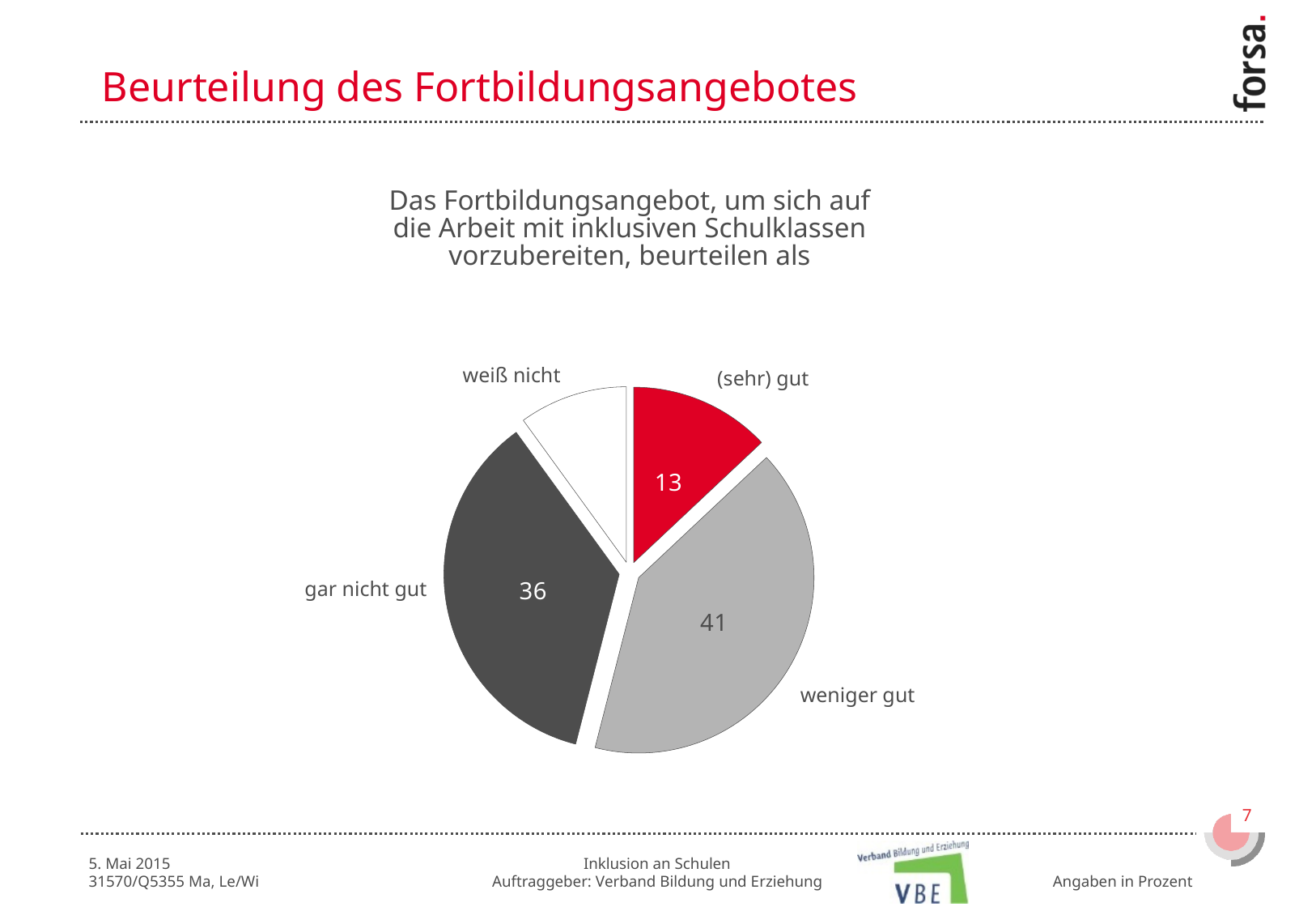
Which category has the smallest slice of the pie? weiß nicht Which is larger, the value for "gar nicht gut" or the value for "(sehr) gut"? gar nicht gut In what unit are the values given, according to the note at the bottom right of the slide? Prozent Which category has the largest slice of the pie? weniger gut What is the value for "gar nicht gut"? 36 What is the value for "(sehr) gut"? 13 How many slices does the pie chart have? 4 What is the value for "weniger gut"? 41 What is the difference between the values for "weniger gut" and "gar nicht gut"? 5 What type of chart is shown on the slide? pie chart Which slice of the pie is coloured red? (sehr) gut What is the difference between the values for "gar nicht gut" and "(sehr) gut"? 23